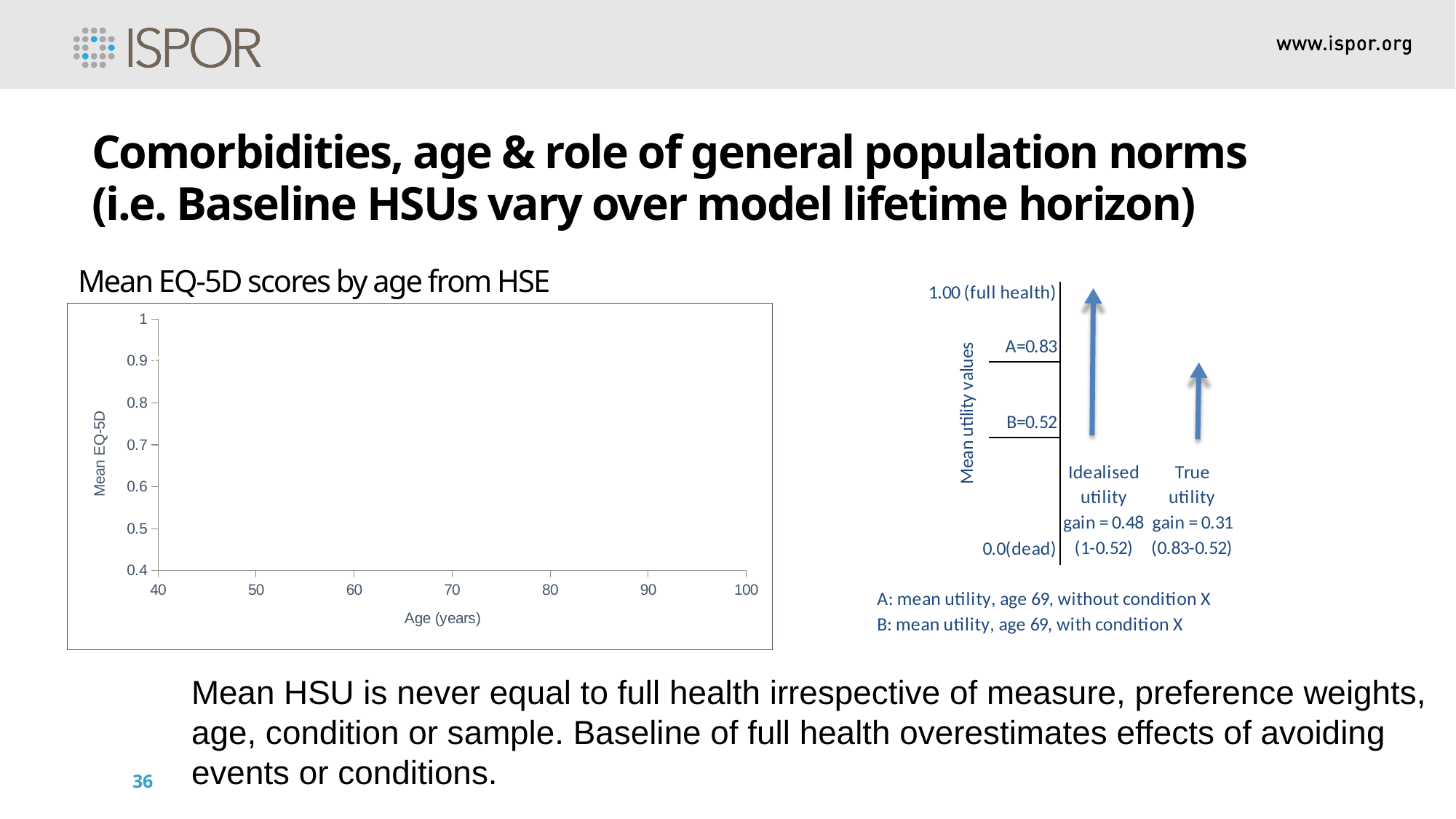
In the diagram on the right, what is the mean utility value labelled B? 0.52 In the diagram on the right, what is the idealised utility gain? 0.48 In the diagram on the right, which is larger, the idealised utility gain or the true utility gain? Idealised utility gain In the diagram on the right, what is the difference between utility value A and utility value B? 0.31 In the diagram on the right, what is the difference between the idealised utility gain and the true utility gain? 0.17 What is the x-axis label of the chart on the left (Mean EQ-5D scores by age from HSE)? Age (years) In the diagram on the right, what is the true utility gain? 0.31 In the diagram on the right, what is the mean utility value labelled A? 0.83 In the diagram on the right, which is larger, the utility value A or the utility value B? A What is the title of the chart on the left of the slide? Mean EQ-5D scores by age from HSE